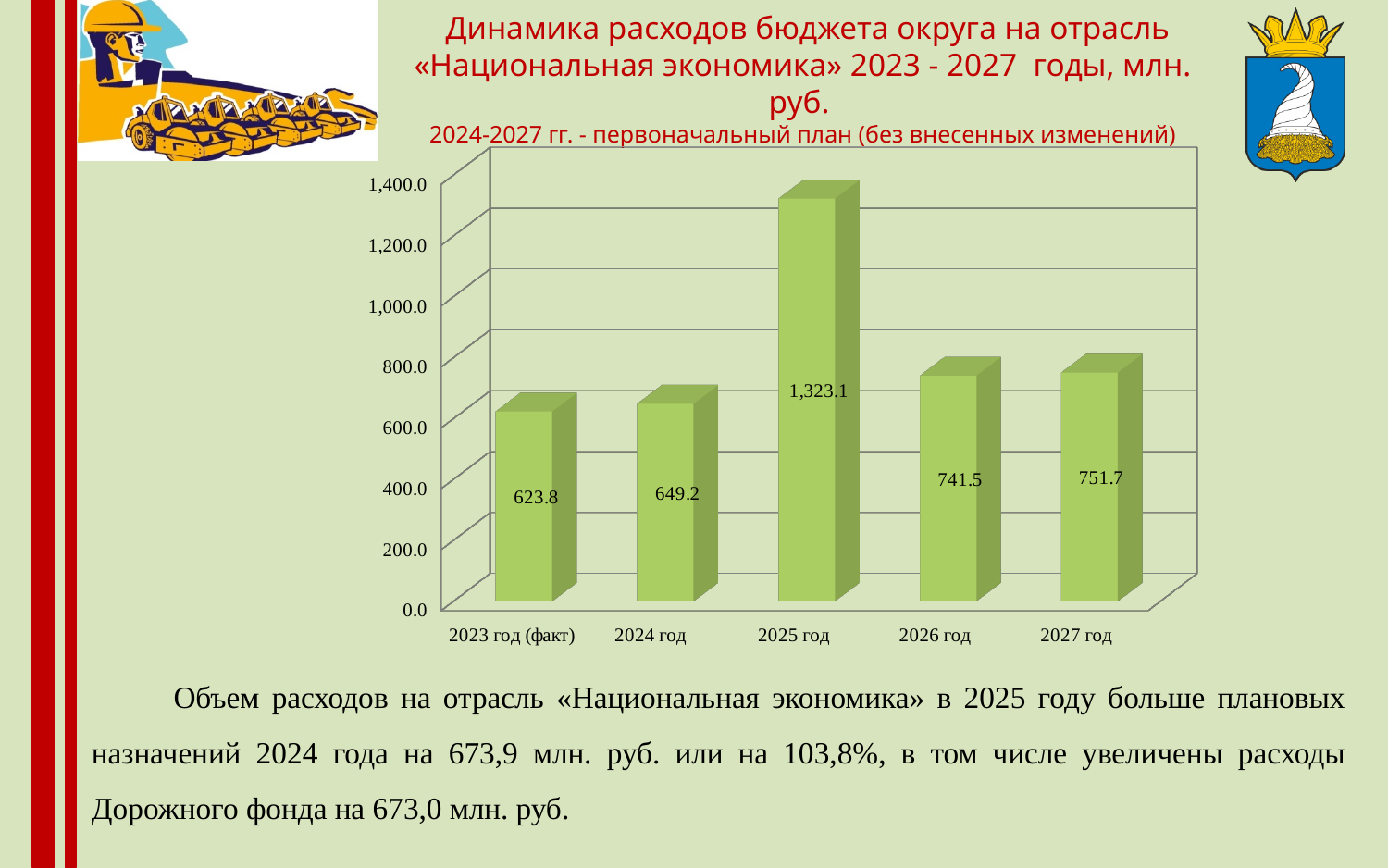
Is the value for 2025 год greater or less than 1,200.0? greater What is the value for 2023 год (факт)? 623.8 What is the value for 2025 год? 1,323.1 What kind of chart is shown on the slide? bar chart Which year has the highest value? 2025 год What does the subtitle below the chart title say about 2024-2027? первоначальный план (без внесенных изменений) What is the difference between the values for 2027 год and 2026 год? 10.2 How many categories are shown on the x axis? 5 What is the value for 2027 год? 751.7 Which category has the lowest value? 2023 год (факт) Which is larger, the value for 2026 год or the value for 2024 год? 2026 год What is the difference between the values for 2025 год and 2024 год? 673.9